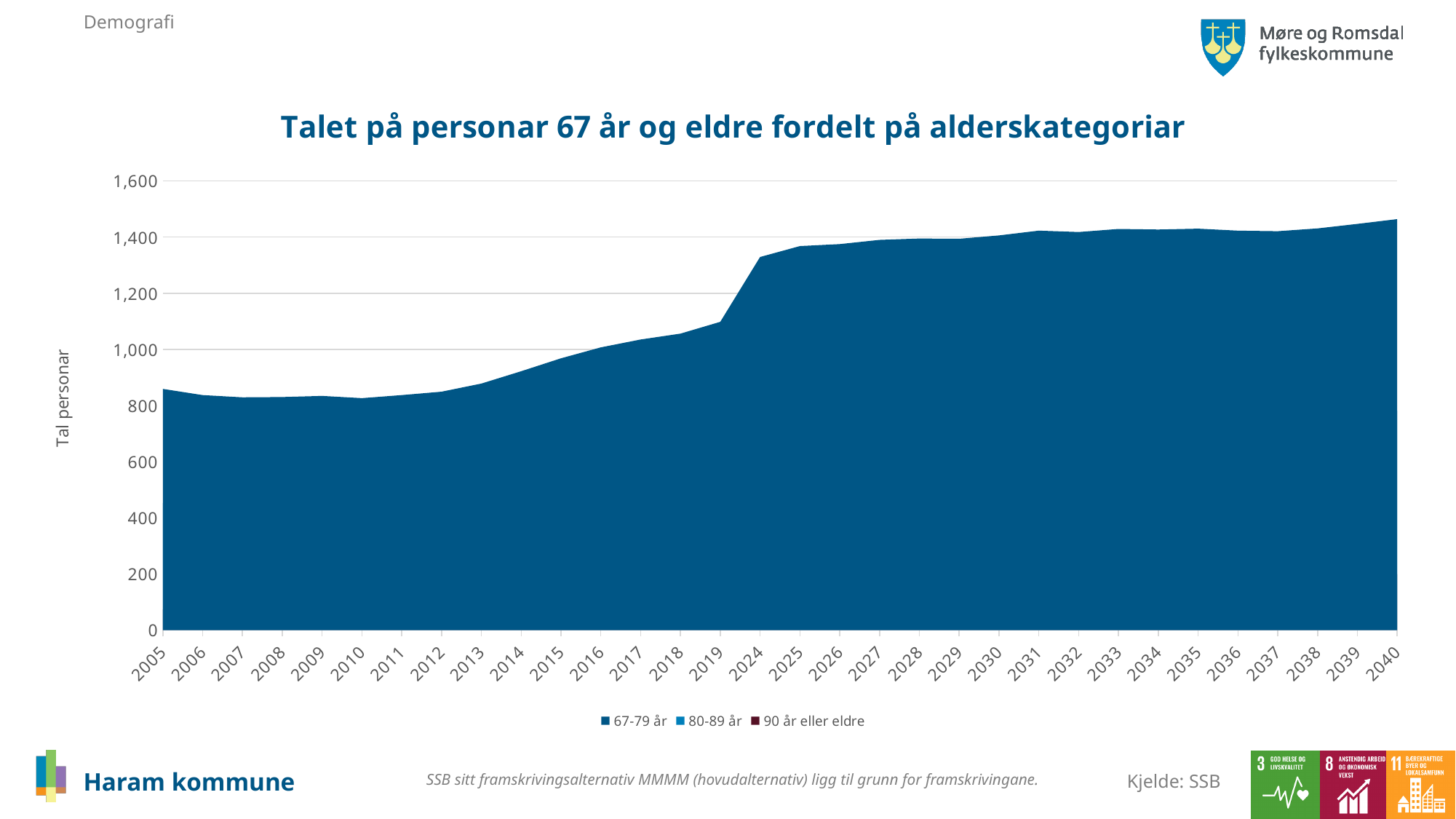
Is the value for 2040 greater or less than 1,600? less Which year has the highest value? 2040 How many years are shown along the x axis? 32 Is the value for 2005 greater or less than 800? greater What is the title of the chart? Talet på personar 67 år og eldre fordelt på alderskategoriar Is the value for 2019 greater or less than 1,000? greater How many series does the legend list? 3 Do the values generally rise or fall from 2005 to 2040? rise What is the label on the vertical axis? Tal personar What kind of chart is shown on the slide? area chart